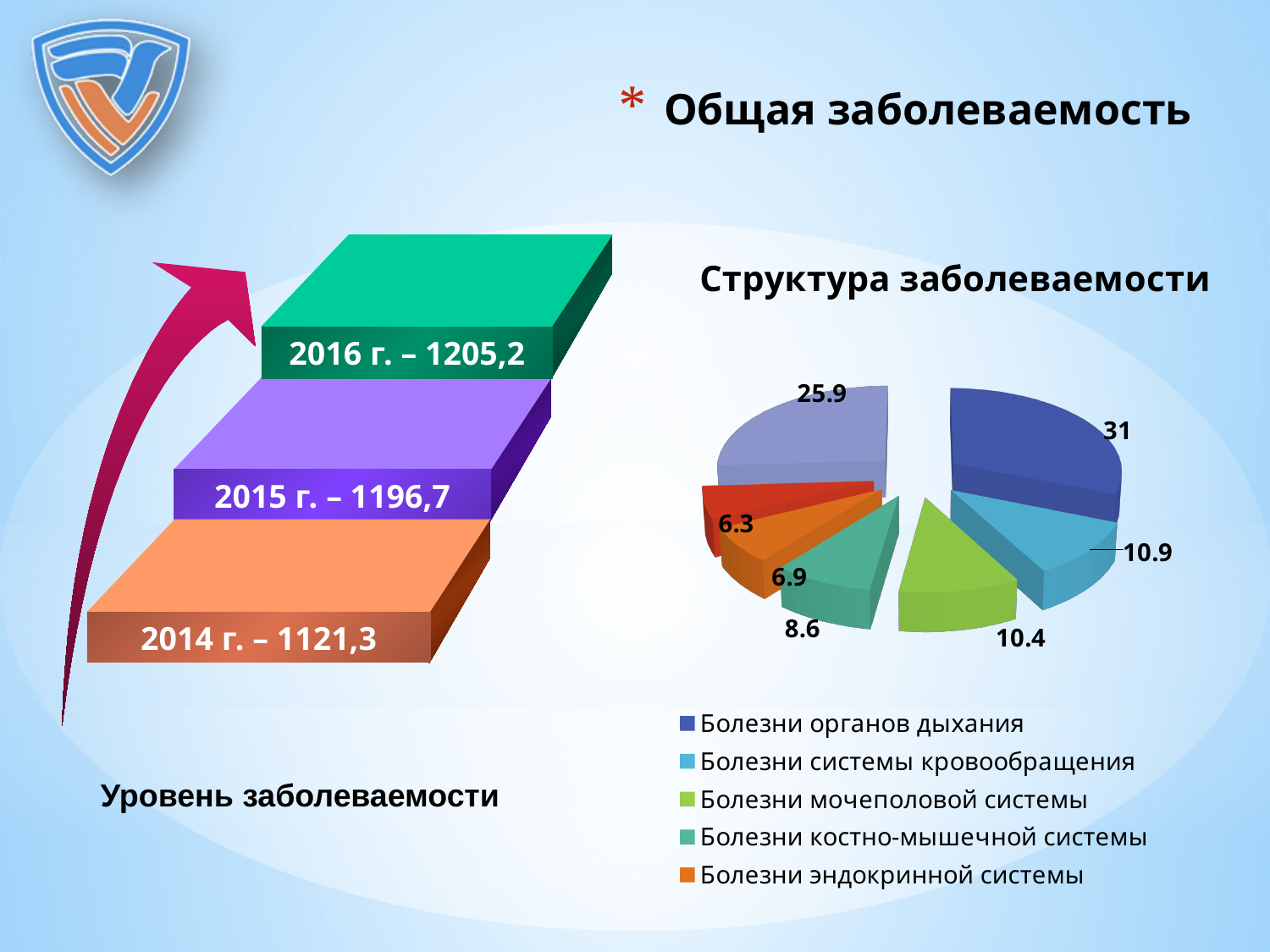
In the pie chart 'Структура заболеваемости', what is the value for Болезни мочеполовой системы? 10.4 In the pie chart 'Структура заболеваемости', what is the value for Болезни эндокринной системы? 6.9 In the pie chart 'Структура заболеваемости', what is the value for Болезни системы кровообращения? 10.9 In the pie chart 'Структура заболеваемости', which is larger: Болезни системы кровообращения or Болезни мочеполовой системы? Болезни системы кровообращения In the pie chart 'Структура заболеваемости', what is the difference between the values for Болезни органов дыхания and Болезни эндокринной системы? 24.1 What kind of chart is 'Структура заболеваемости'? Pie chart In the pie chart 'Структура заболеваемости', which legend category has the largest slice? Болезни органов дыхания In the 'Уровень заболеваемости' graphic on the left, what is the value shown for 2016 г.? 1205,2 In the pie chart 'Структура заболеваемости', what is the value for Болезни костно-мышечной системы? 8.6 How many slices does the pie chart 'Структура заболеваемости' have? 7 How many entries does the legend of the pie chart 'Структура заболеваемости' list? 5 In the pie chart 'Структура заболеваемости', what is the value for Болезни органов дыхания? 31